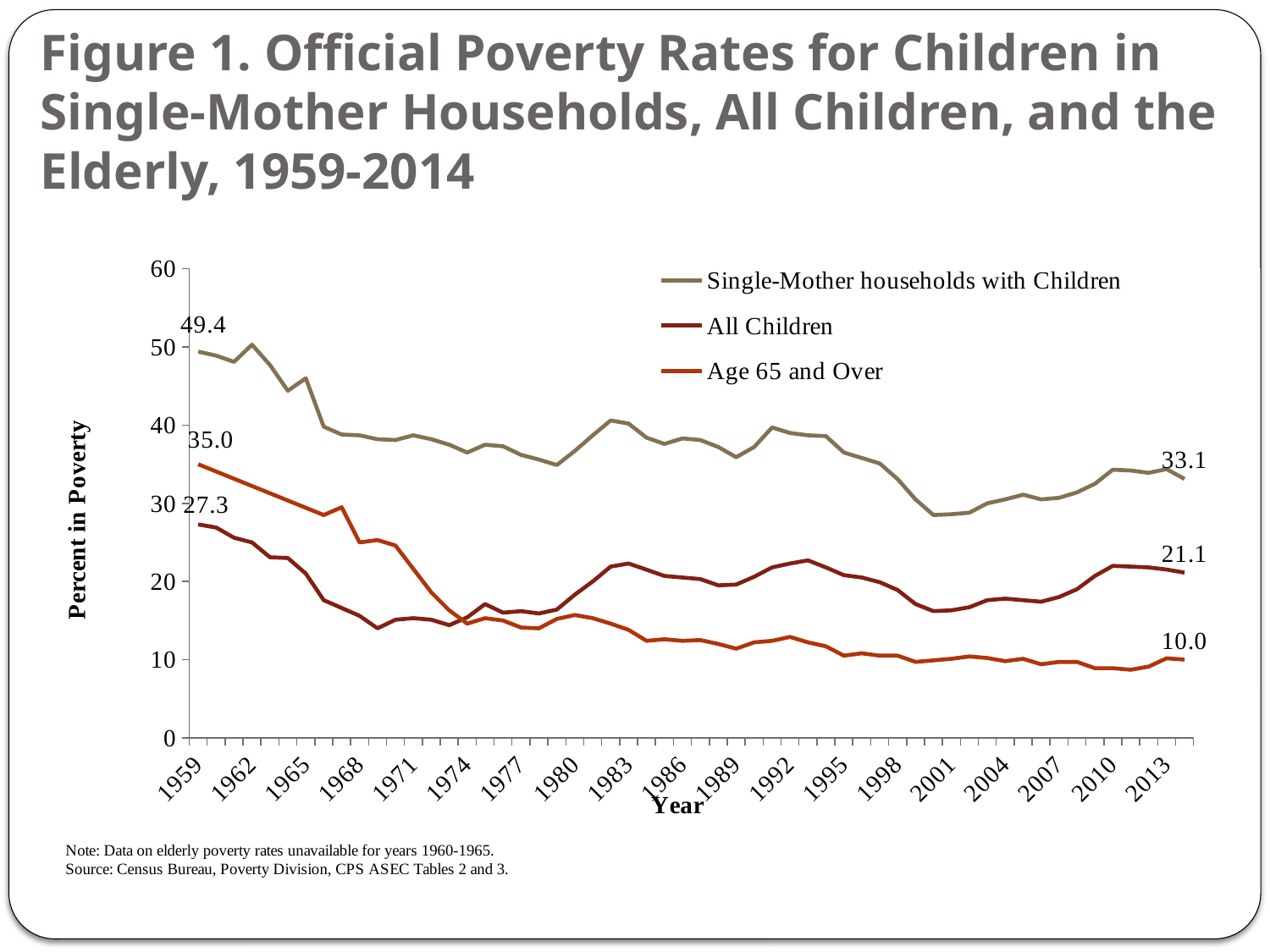
How many series does the legend list? 3 What was the poverty rate for Age 65 and Over in 2014? 10.0 Which series had the highest poverty rate in 2014? Single-Mother households with Children What was the poverty rate for All Children in 1959? 27.3 By how much did the poverty rate for Single-Mother households with Children fall from 1959 to 2014? 16.3 Does the poverty rate for Age 65 and Over generally rise or fall from 1959 to 2014? fall What was the poverty rate for Age 65 and Over in 1959? 35.0 What was the poverty rate for Single-Mother households with Children in 2014? 33.1 What was the poverty rate for Single-Mother households with Children in 1959? 49.4 By how much did the poverty rate for Age 65 and Over fall from 1959 to 2014? 25.0 Is the poverty rate for All Children in 2001 greater or less than 20? less What type of chart is shown on the slide? line chart